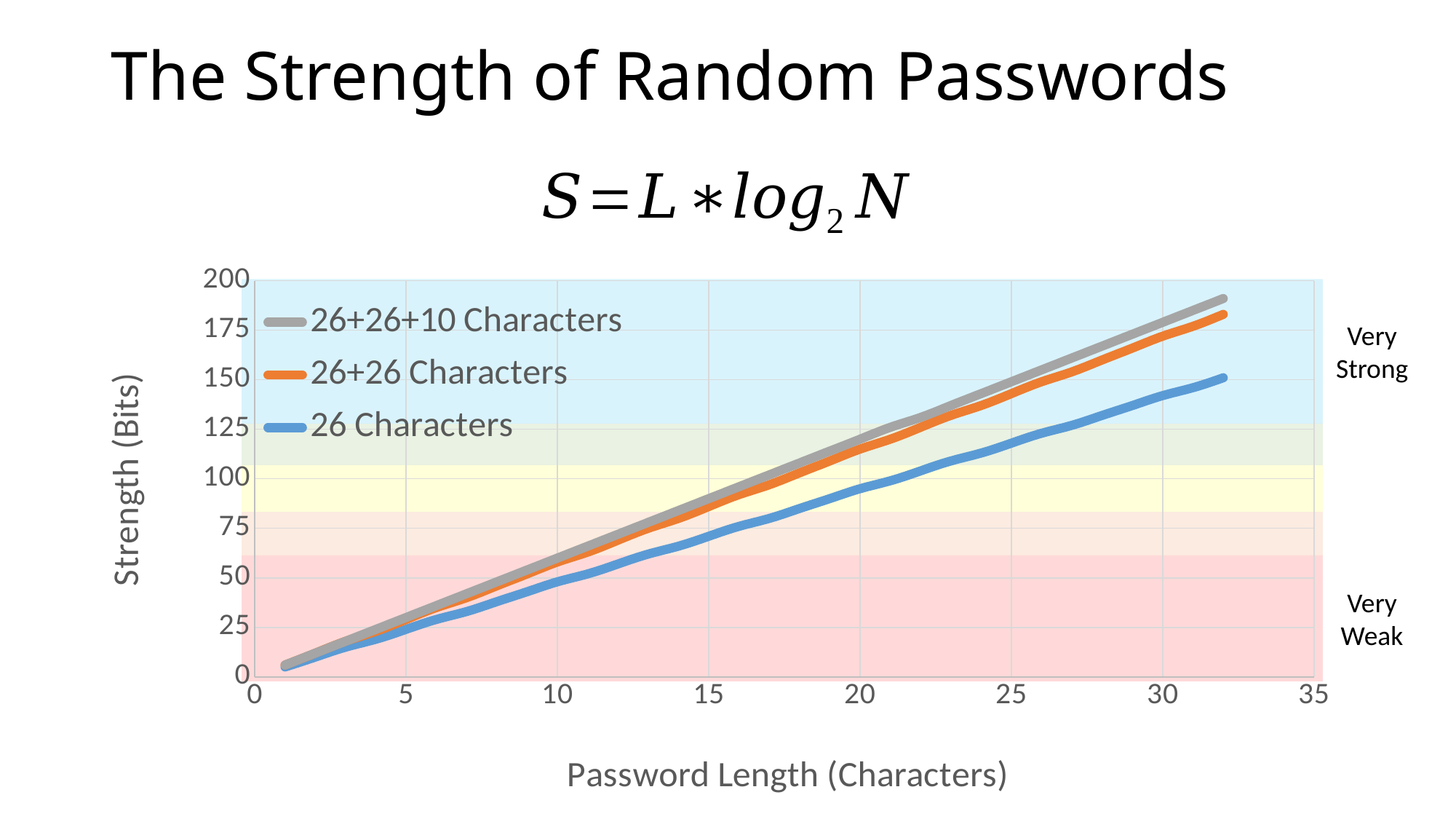
Which series has the lowest strength at a password length of 32 characters? 26 Characters At a password length of 30, is the value for 26 Characters greater or less than 125? greater What is the title of the chart's vertical axis? Strength (Bits) What is the title of the chart's horizontal axis? Password Length (Characters) What kind of chart is shown on the slide? line chart Which series reaches the highest strength at a password length of 32 characters? 26+26+10 Characters At a password length of 20, is the value for 26+26 Characters greater or less than 100? greater Do the strength values rise or fall as password length increases? rise How many series does the chart's legend list? 3 At a password length of 10, is the value for 26+26+10 Characters greater or less than 50? greater At a password length of 32, which is larger: the value for 26+26+10 Characters or the value for 26 Characters? 26+26+10 Characters